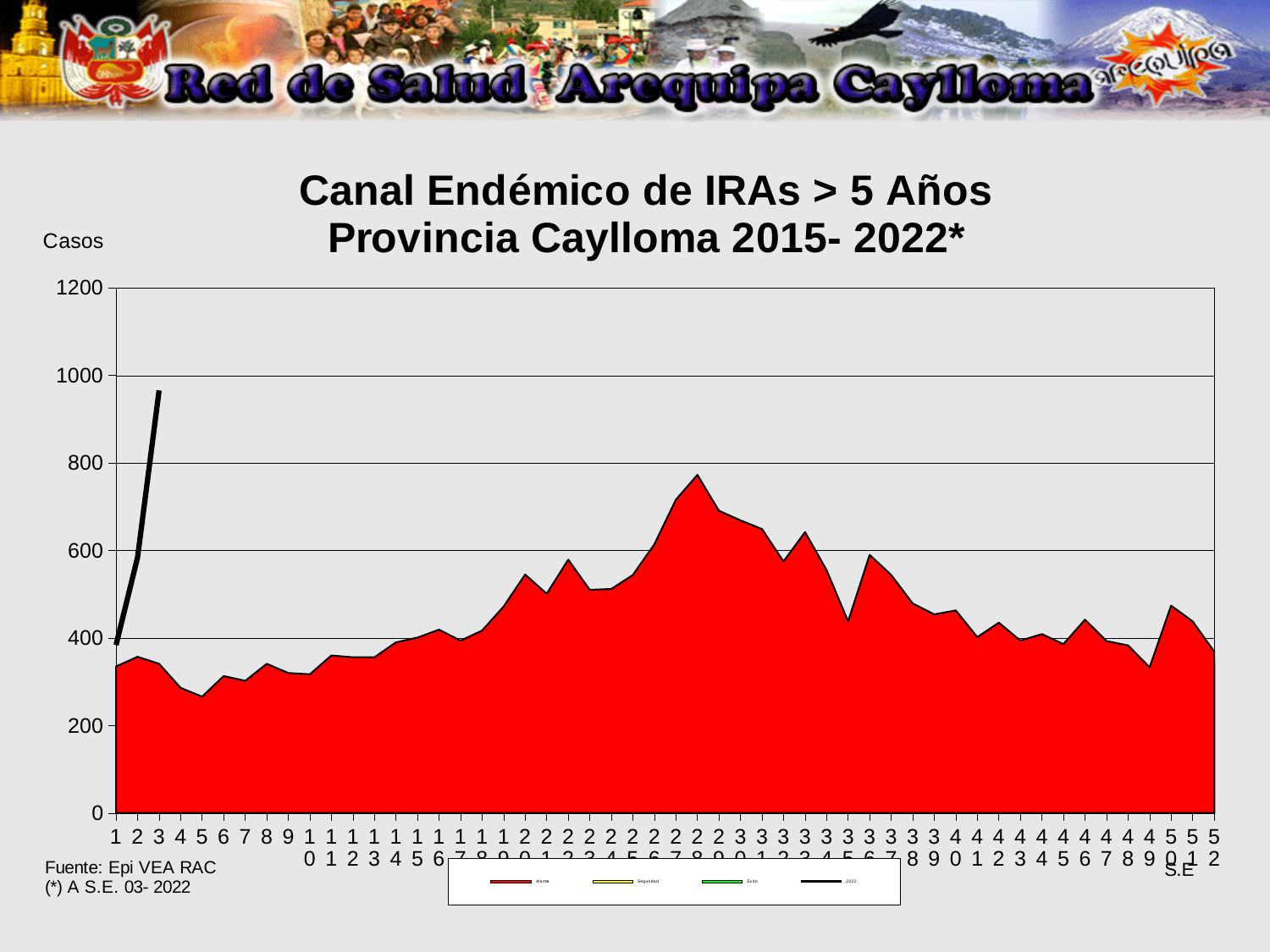
What type of chart is shown on the slide? Combination area and line chart What is the highest value shown on the vertical axis? 1200 Does the black 2022 line rise or fall from week 1 to week 3? Rises What is the title of the chart? Canal Endémico de IRAs > 5 Años Provincia Caylloma 2015- 2022* Is the value of the red area at week 1 greater or less than 400? less What label is shown on the vertical axis of the chart? Casos Is the value of the black 2022 line at week 3 greater or less than 800? greater Is the peak of the red area at week 28 greater or less than 600? greater At which week does the red area reach its highest value? 28 How many epidemiological weeks (S.E.) are shown along the x axis? 52 Which is larger at week 3: the black 2022 line or the red area? The black 2022 line